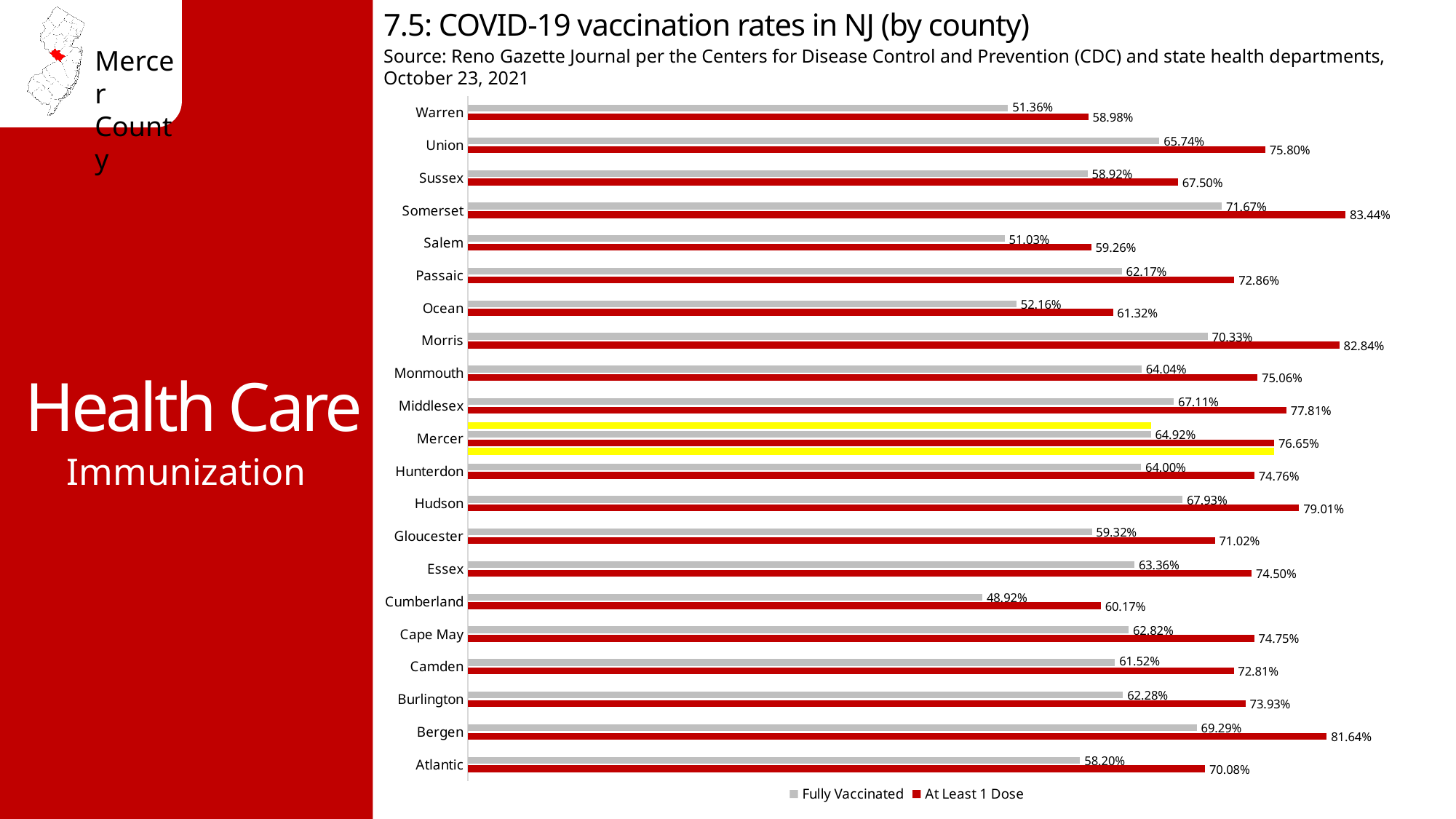
What is the At Least 1 Dose rate for Cumberland County? 60.17% Which county has the lowest At Least 1 Dose rate? Warren Which county has a higher At Least 1 Dose rate, Ocean or Gloucester? Gloucester What kind of chart is shown on the slide? Bar chart How many counties are shown in the chart? 21 How many series does the legend list? 2 Which county has a higher Fully Vaccinated rate, Bergen or Hudson? Bergen Which county has the lowest Fully Vaccinated rate? Cumberland What is the difference between Mercer County's At Least 1 Dose rate and its Fully Vaccinated rate? 11.73 percentage points Which county has the highest Fully Vaccinated rate? Somerset What is the At Least 1 Dose rate for Somerset County? 83.44% What is the Fully Vaccinated rate for Mercer County? 64.92%